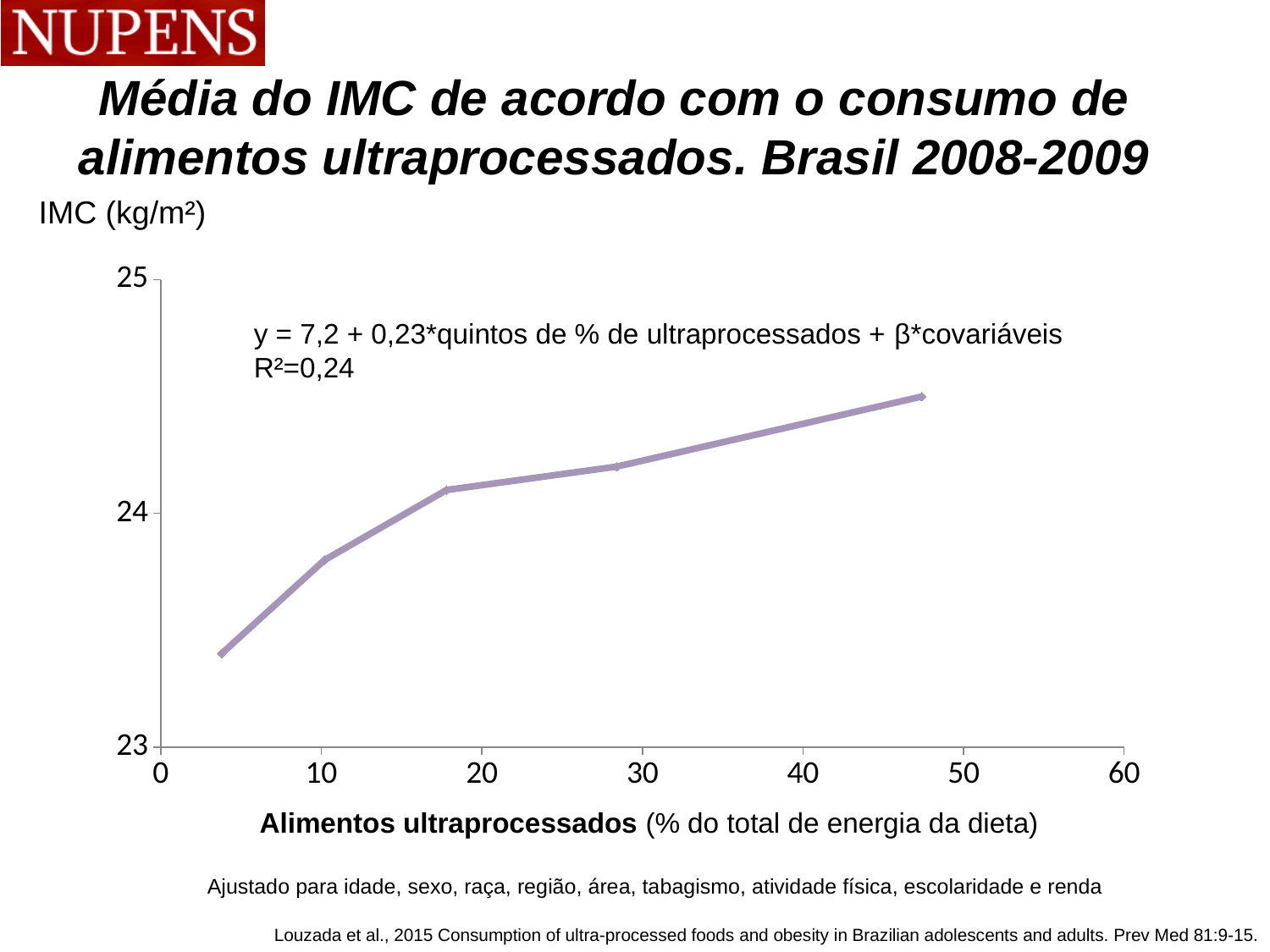
Which point has the highest IMC value, the leftmost or the rightmost? the rightmost What kind of chart is shown on the slide? line chart Is the IMC value for the last (rightmost) point greater or less than 25? less Is the IMC value for the last (rightmost) point greater or less than 24? greater Is the IMC value for the second point (near 10% on the x axis) greater or less than 24? less What is the R² value shown on the chart? 0,24 How many data points are plotted on the line? 5 What unit is given for IMC on the y axis label? kg/m² Do the IMC values rise or fall as the share of ultraprocessed foods increases along the x axis? rise